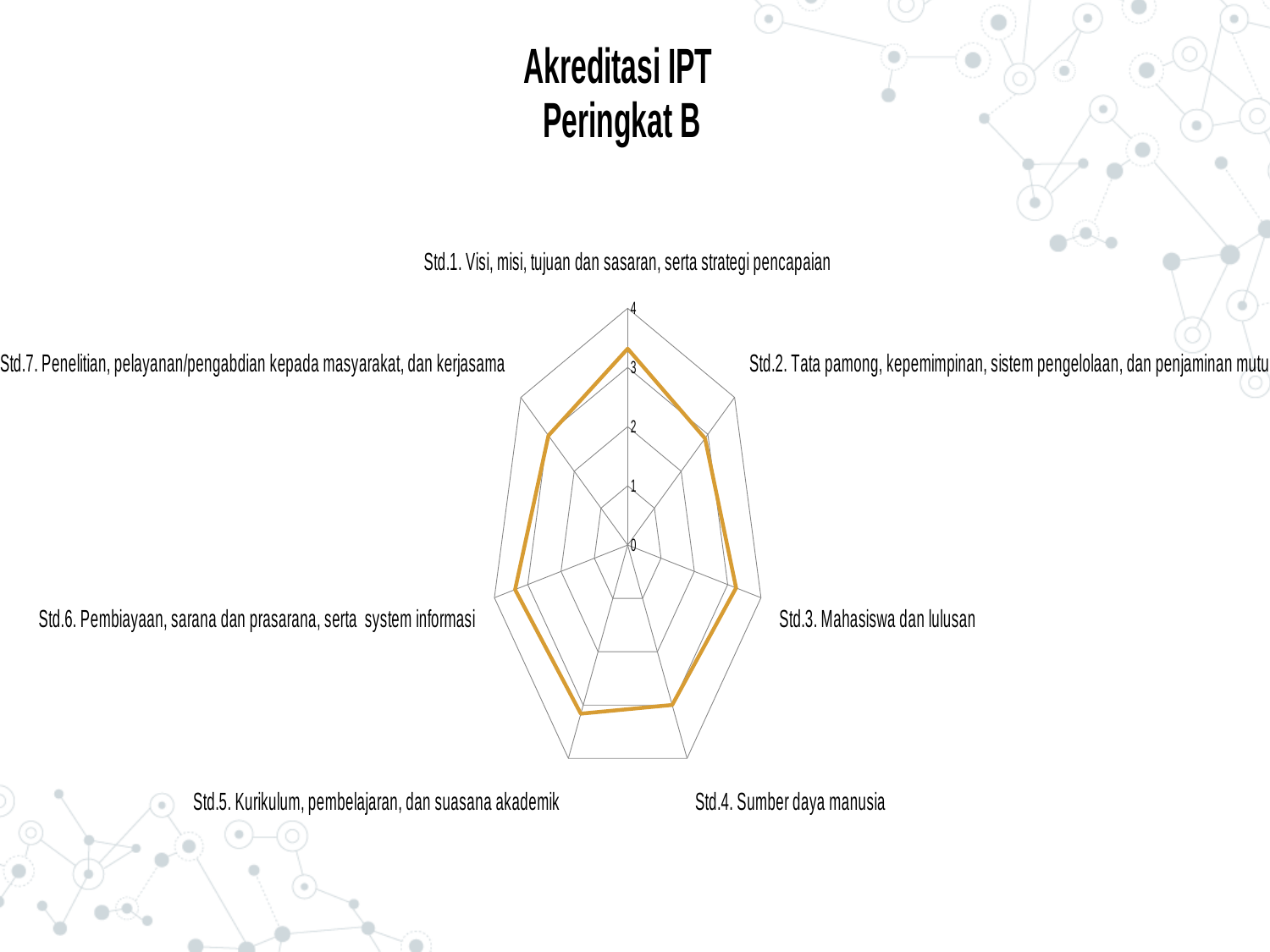
Is the value for Std.3 (Mahasiswa dan lulusan) greater or less than 2? greater How many data series are plotted on the radar chart? 1 Is the value for Std.1 (Visi, misi, tujuan dan sasaran, serta strategi pencapaian) greater or less than 3? greater Is the value for Std.1 (Visi, misi, tujuan dan sasaran, serta strategi pencapaian) greater or less than 4? less What kind of chart is shown on the slide? Radar chart How many categories (standards) are plotted on the radar chart? 7 What is the title of the chart? Akreditasi IPT Peringkat B What is the highest value shown on the chart's axis scale? 4